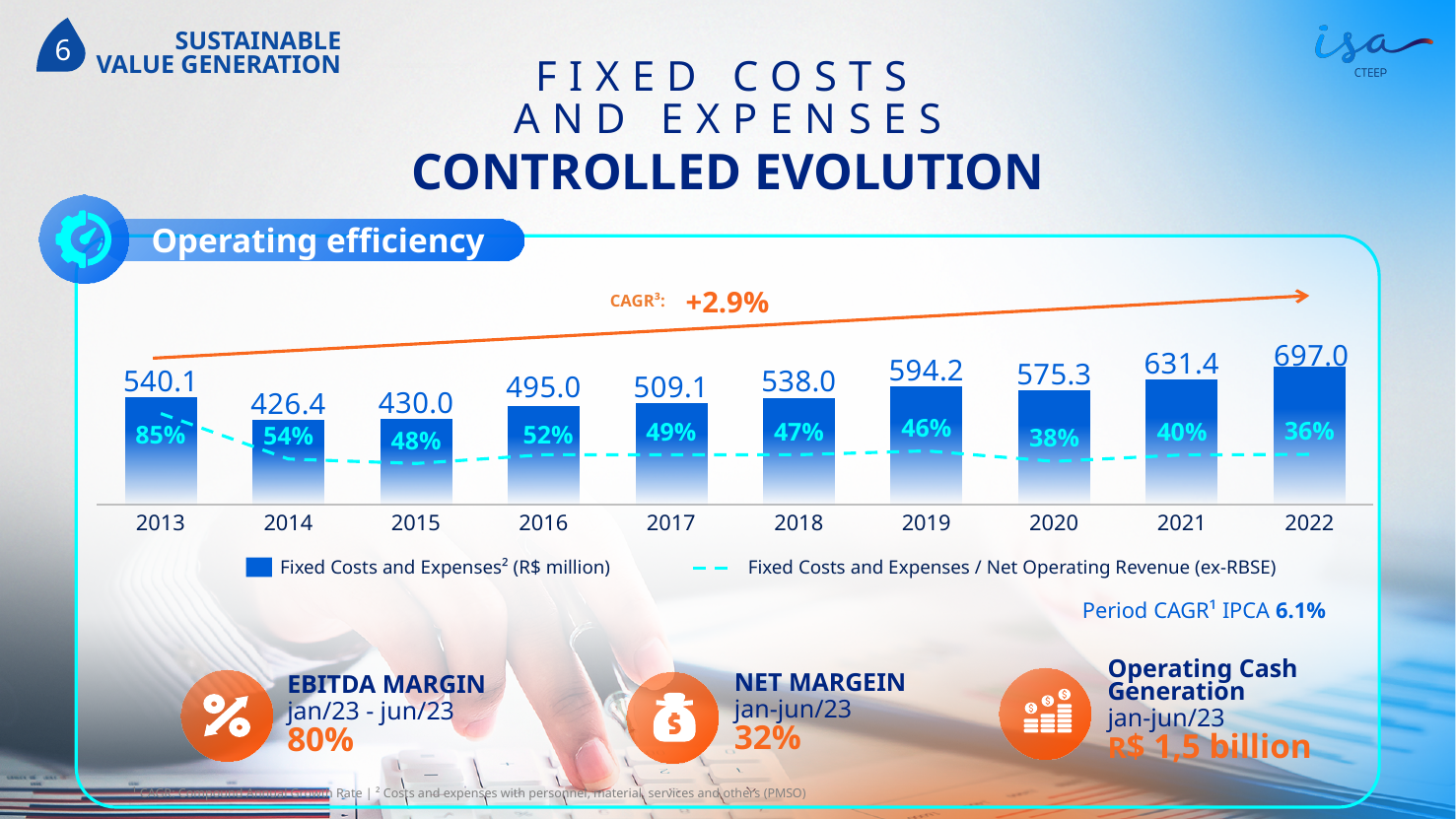
Which year has the lowest Fixed Costs and Expenses (R$ million)? 2014 What is the value of Fixed Costs and Expenses (R$ million) for 2022? 697.0 What is the difference in Fixed Costs and Expenses (R$ million) between 2022 and 2021? 65.6 How many series does the chart legend list? 2 What is the value of Fixed Costs and Expenses (R$ million) for 2019? 594.2 What kind of chart is used to show Fixed Costs and Expenses (R$ million)? Bar chart What CAGR is shown above the bars in the chart? +2.9% Which year has the lowest Fixed Costs and Expenses / Net Operating Revenue (ex-RBSE) ratio? 2022 Which year has higher Fixed Costs and Expenses (R$ million), 2019 or 2020? 2019 What is the Fixed Costs and Expenses / Net Operating Revenue (ex-RBSE) ratio for 2013? 85% Which year has the highest Fixed Costs and Expenses (R$ million)? 2022 How many years are shown on the x axis of the chart? 10